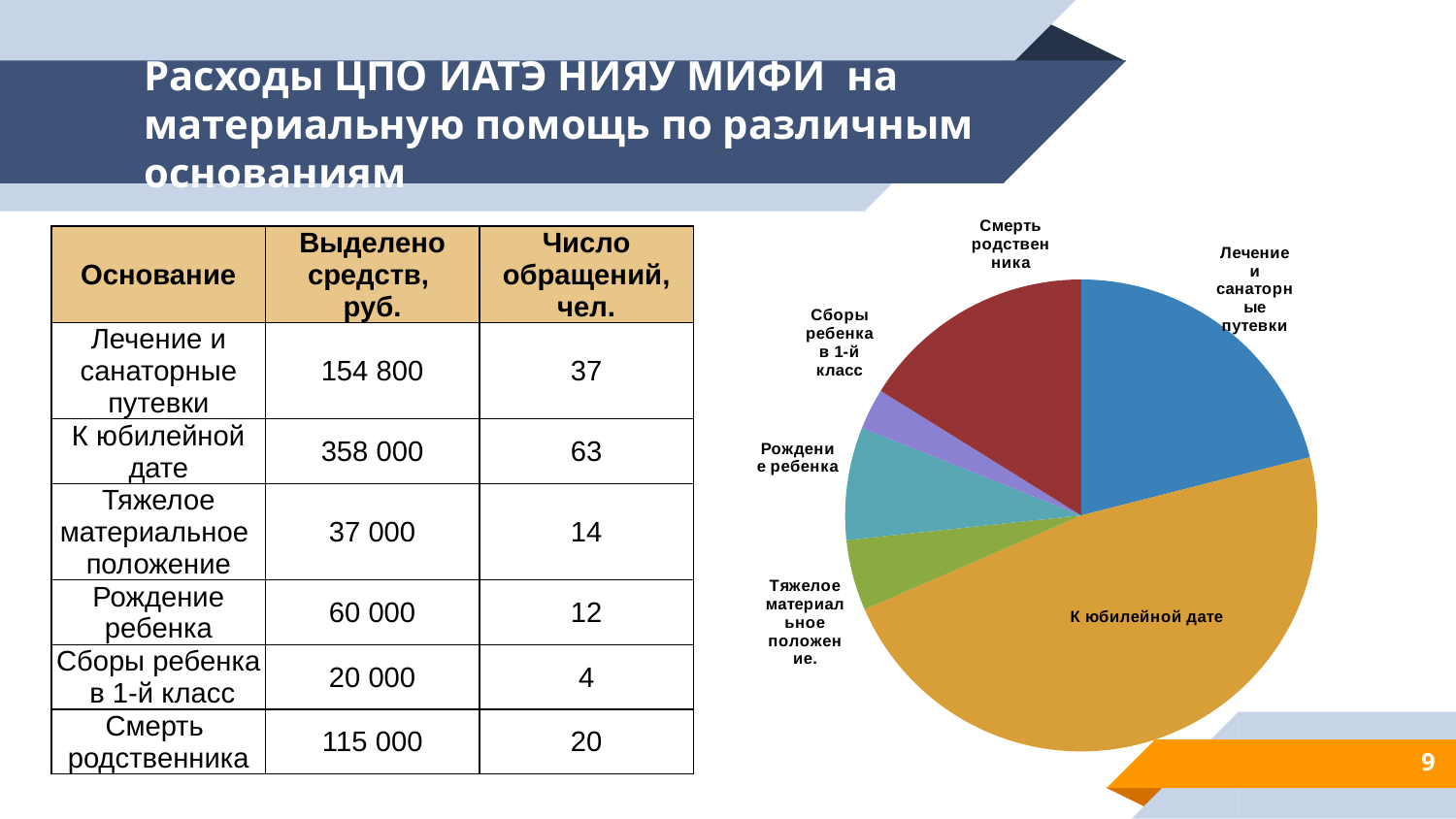
According to the table on the slide, how many rubles were allocated for К юбилейной дате? 358 000 What kind of chart is shown on the right side of the slide? pie chart Which category has the smallest slice in the pie chart? Сборы ребенка в 1-й класс In the pie chart, which slice is larger: Рождение ребенка or Тяжелое материальное положение? Рождение ребенка How many slices does the pie chart have? 6 According to the table on the slide, how many rubles were allocated for Сборы ребенка в 1-й класс? 20 000 Which category has the largest slice in the pie chart? К юбилейной дате In the pie chart, which slice is larger: Смерть родственника or Рождение ребенка? Смерть родственника What colour is the slice for Смерть родственника in the pie chart? dark red In the pie chart, which slice is larger: Лечение и санаторные путевки or Смерть родственника? Лечение и санаторные путевки What colour is the largest slice of the pie chart? orange According to the table on the slide, what is the difference in allocated funds between К юбилейной дате and Лечение и санаторные путевки? 203 200